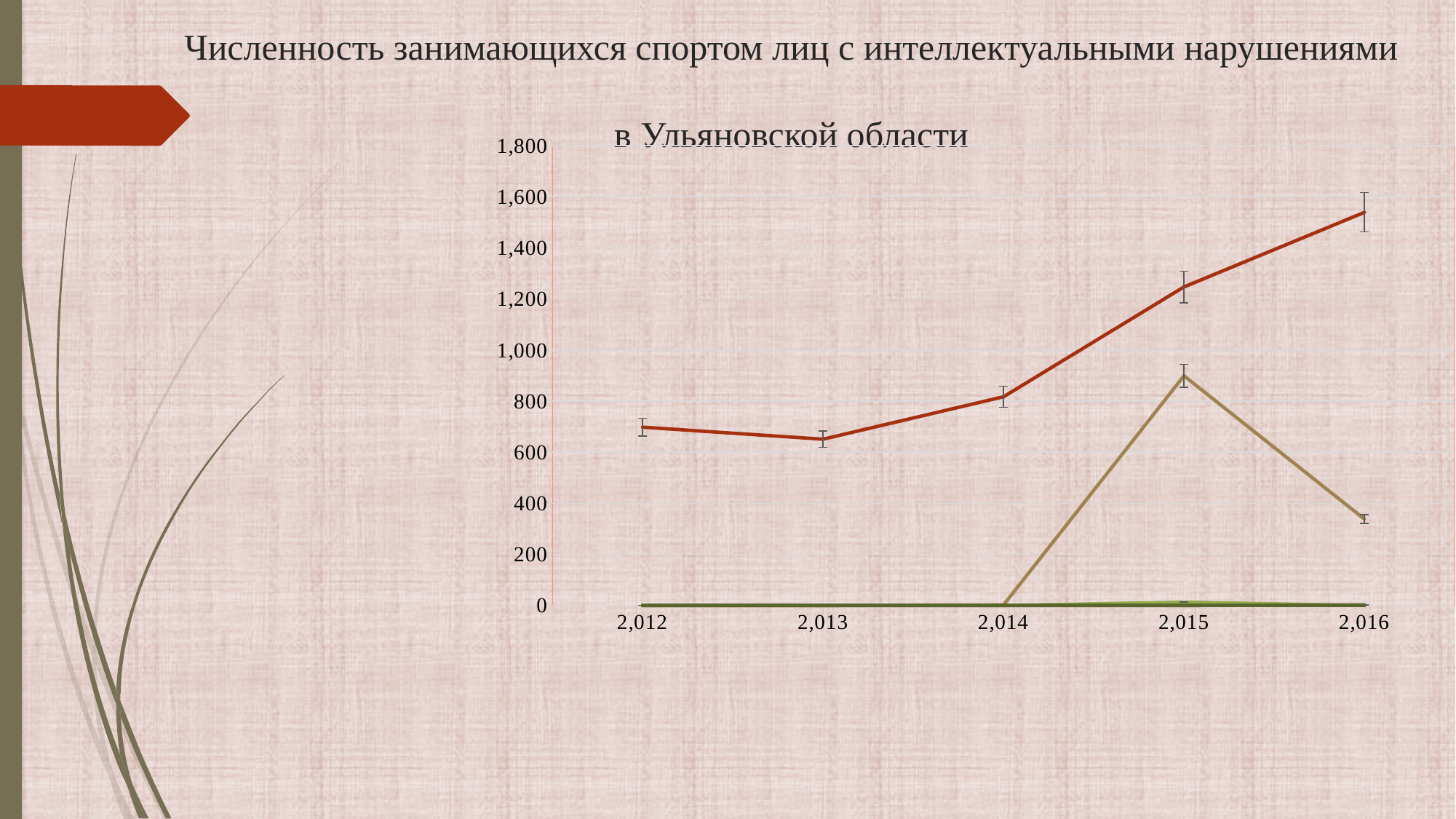
What is the title of the chart on the slide? Численность занимающихся спортом лиц с интеллектуальными нарушениями в Ульяновской области In which year does the red line reach its highest value? 2,016 How many years are marked along the x axis of the chart? 5 In which year does the red line reach its lowest value? 2,013 Is the value of the red line at 2,015 greater or less than 1,000? greater Is the value of the tan line at 2,016 greater or less than 400? less Is the value of the red line at 2,016 greater or less than 1,400? greater Does the red line rise or fall between 2,014 and 2,016? rises What kind of chart is shown on the slide? line chart In which year does the tan (light brown) line reach its highest value? 2,015 At 2,015, which line is higher, the red line or the tan line? the red line